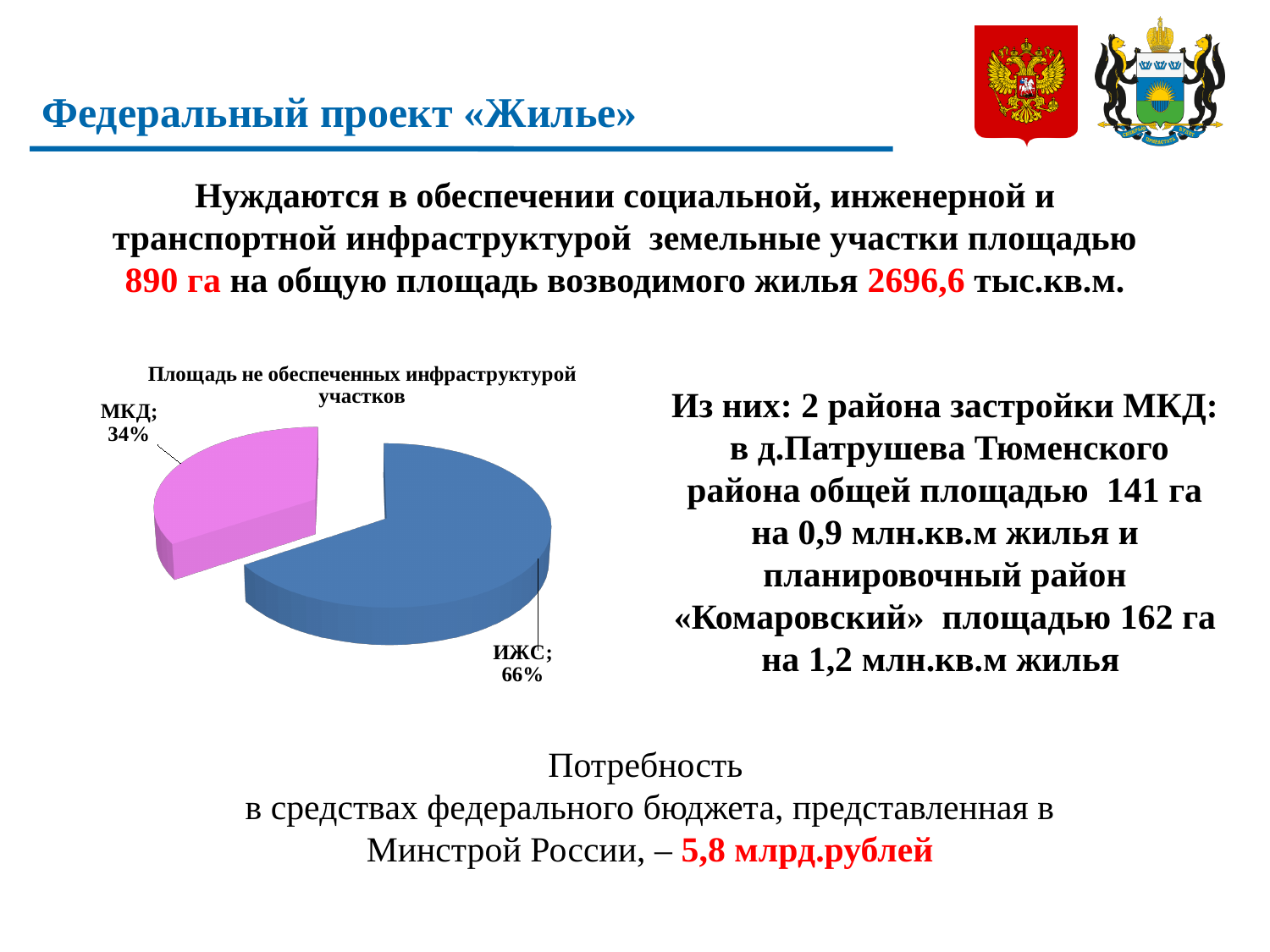
How many slices does the pie chart have? 2 What share of the pie does ИЖС account for? 66% What share of the pie does МКД account for? 34% By how many percentage points does the ИЖС share exceed the МКД share? 32% What type of chart is shown on the slide? pie chart What colour is the ИЖС slice in the pie chart? blue Which slice of the pie chart is the smallest? МКД Which slice of the pie chart is the largest? ИЖС What is the title of the pie chart? Площадь не обеспеченных инфраструктурой участков Which is larger in the pie chart, МКД or ИЖС? ИЖС